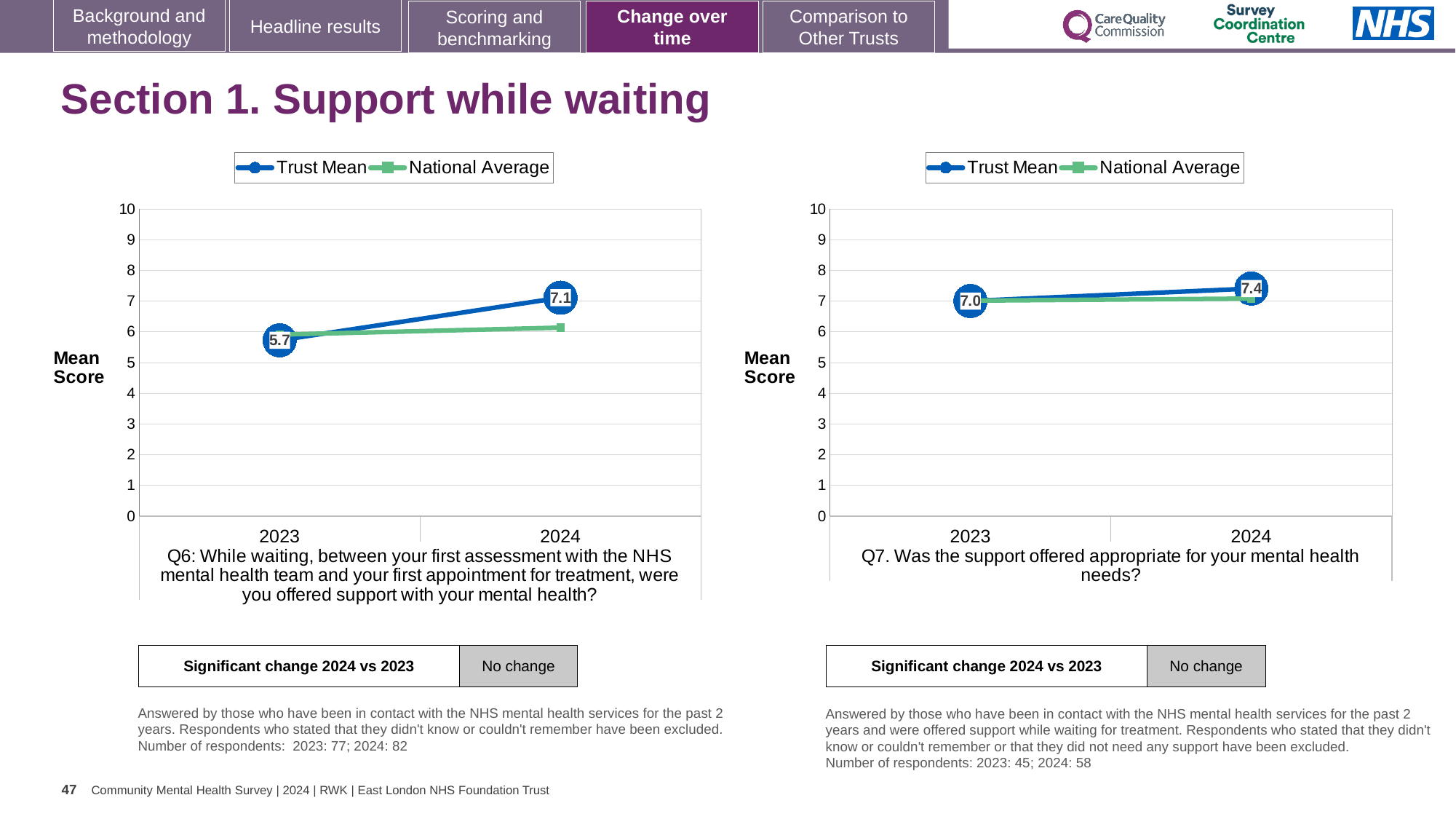
On the left chart (Q6), what is the Trust Mean score for 2023? 5.7 On the left chart (Q6), is the National Average for 2024 greater or less than 7? less On the left chart (Q6), what is the Trust Mean score for 2024? 7.1 What kind of chart is the right chart (Q7)? line chart On the right chart (Q7), what is the difference between the Trust Mean in 2024 and in 2023? 0.4 How many series does the legend of the right chart (Q7) list? 2 On the right chart (Q7), what is the Trust Mean score for 2024? 7.4 On the left chart (Q6), by how much did the Trust Mean change from 2023 to 2024? 1.4 How many years are shown on the x axis of the left chart (Q6)? 2 On the right chart (Q7), what is the Trust Mean score for 2023? 7.0 On the left chart (Q6), does the Trust Mean rise or fall from 2023 to 2024? rise On the left chart (Q6), in 2024, which is larger: the Trust Mean or the National Average? Trust Mean